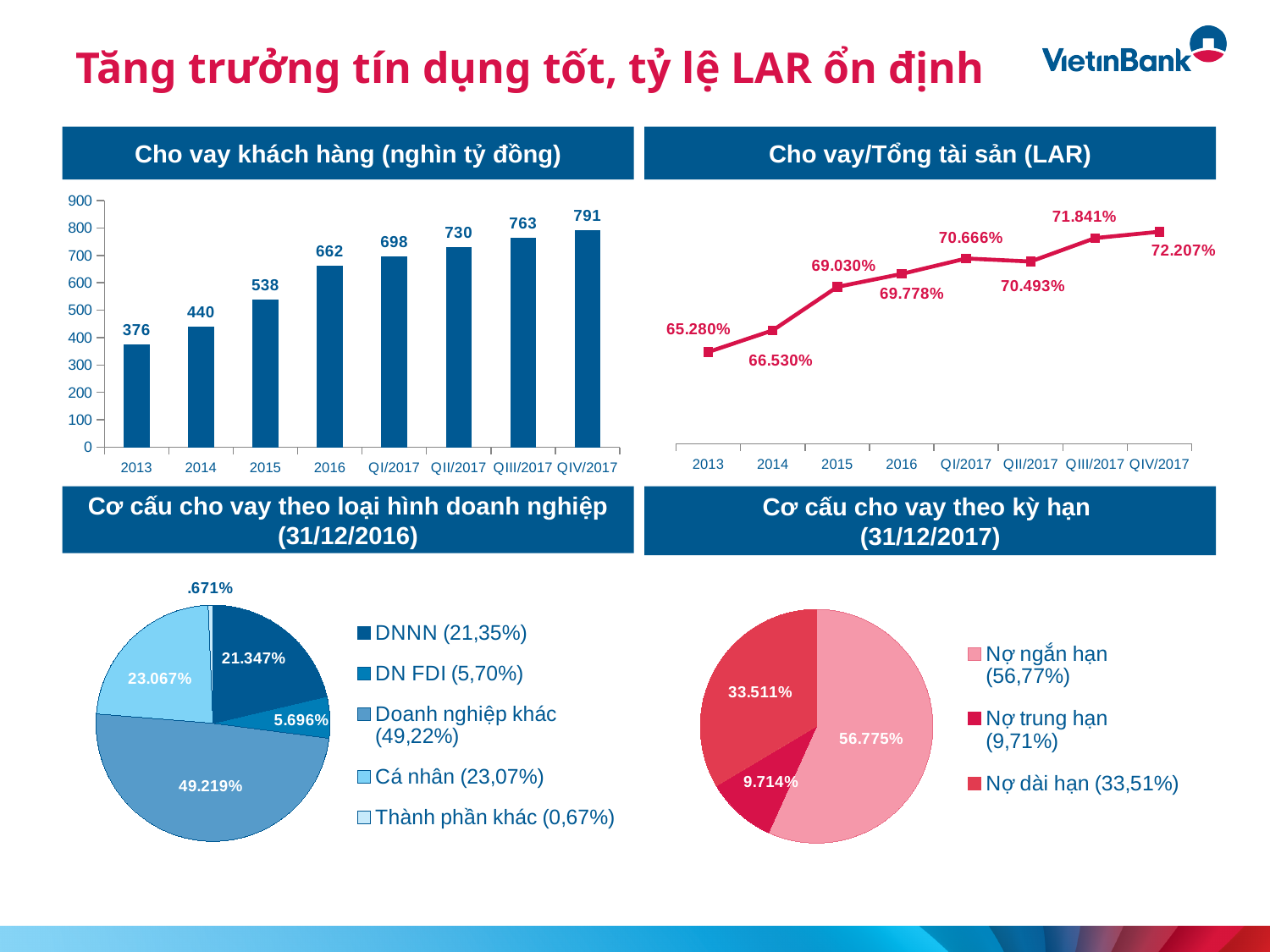
In the chart 'Cho vay/Tổng tài sản (LAR)', which is larger, the value for QI/2017 or QII/2017? QI/2017 In the chart 'Cho vay khách hàng (nghìn tỷ đồng)', how many periods are shown on the x axis? 8 What kind of chart is 'Cho vay khách hàng (nghìn tỷ đồng)'? Bar chart In the pie chart 'Cơ cấu cho vay theo loại hình doanh nghiệp (31/12/2016)', how many categories does the legend list? 5 In the pie chart 'Cơ cấu cho vay theo kỳ hạn (31/12/2017)', which category has the smallest share? Nợ trung hạn What kind of chart is 'Cho vay/Tổng tài sản (LAR)'? Line chart In the pie chart 'Cơ cấu cho vay theo loại hình doanh nghiệp (31/12/2016)', what share does 'Doanh nghiệp khác' have? 49.219% In the chart 'Cho vay khách hàng (nghìn tỷ đồng)', what is the difference between the values for QIV/2017 and 2013? 415 In the chart 'Cho vay/Tổng tài sản (LAR)', which period has the lowest value? 2013 In the chart 'Cho vay khách hàng (nghìn tỷ đồng)', which period has the highest value? QIV/2017 In the chart 'Cho vay/Tổng tài sản (LAR)', what is the value for QIV/2017? 72.207% In the chart 'Cho vay khách hàng (nghìn tỷ đồng)', what is the value for 2015? 538